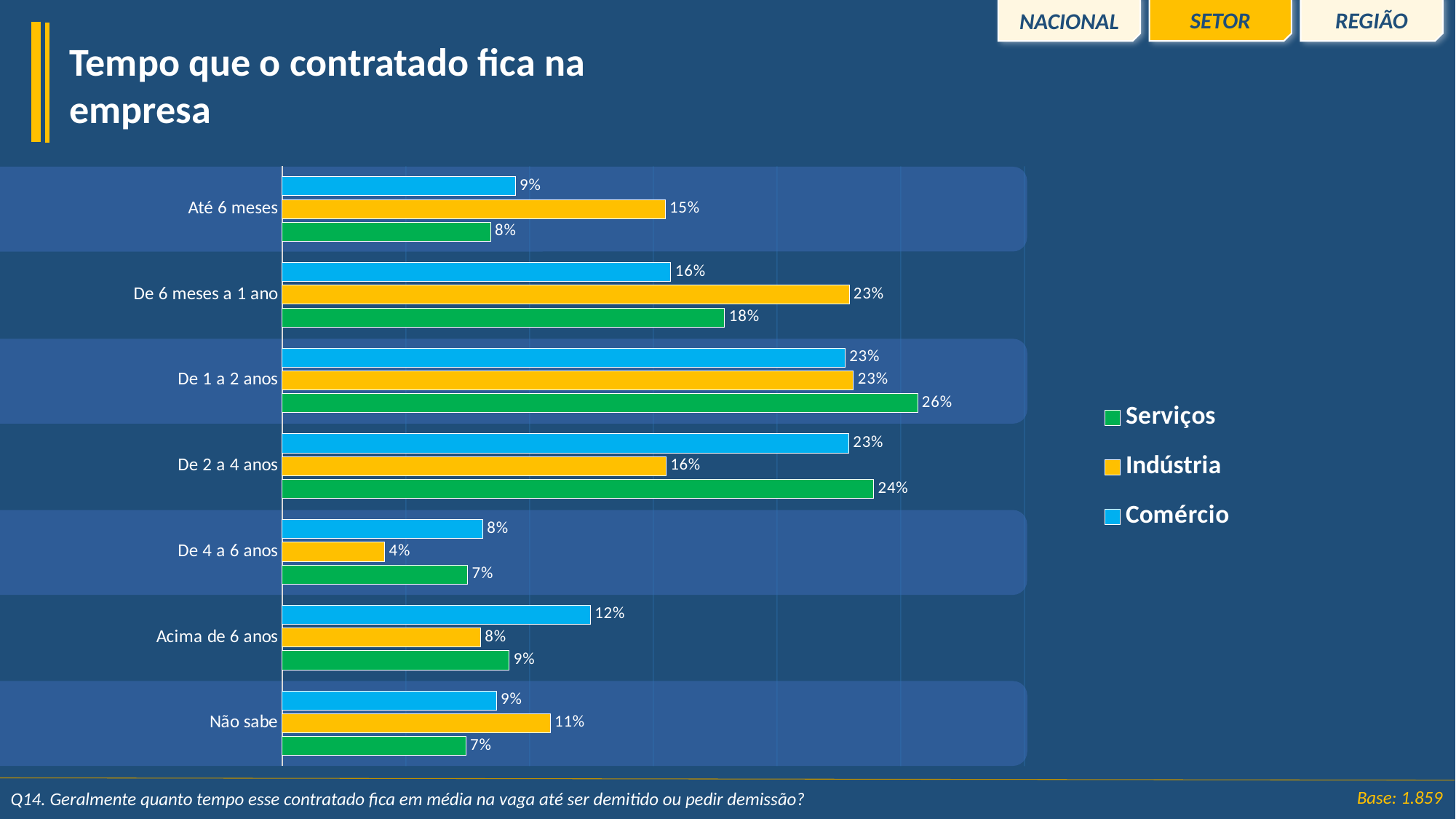
Which category has the lowest Indústria value? De 4 a 6 anos What is the Comércio value for 'Acima de 6 anos'? 12% What is the Comércio value for 'Não sabe'? 9% What is the Serviços value for 'De 1 a 2 anos'? 26% Which colour represents the Indústria series in the legend? Yellow How many series does the legend list? 3 What kind of chart is shown on the slide? Bar chart What is the Indústria value for 'Até 6 meses'? 15% For 'De 6 meses a 1 ano', which is larger: the Indústria value or the Comércio value? Indústria Which category has the highest Serviços value? De 1 a 2 anos What is the difference between the Serviços and Indústria values for 'De 2 a 4 anos'? 8% How many categories are shown on the chart? 7